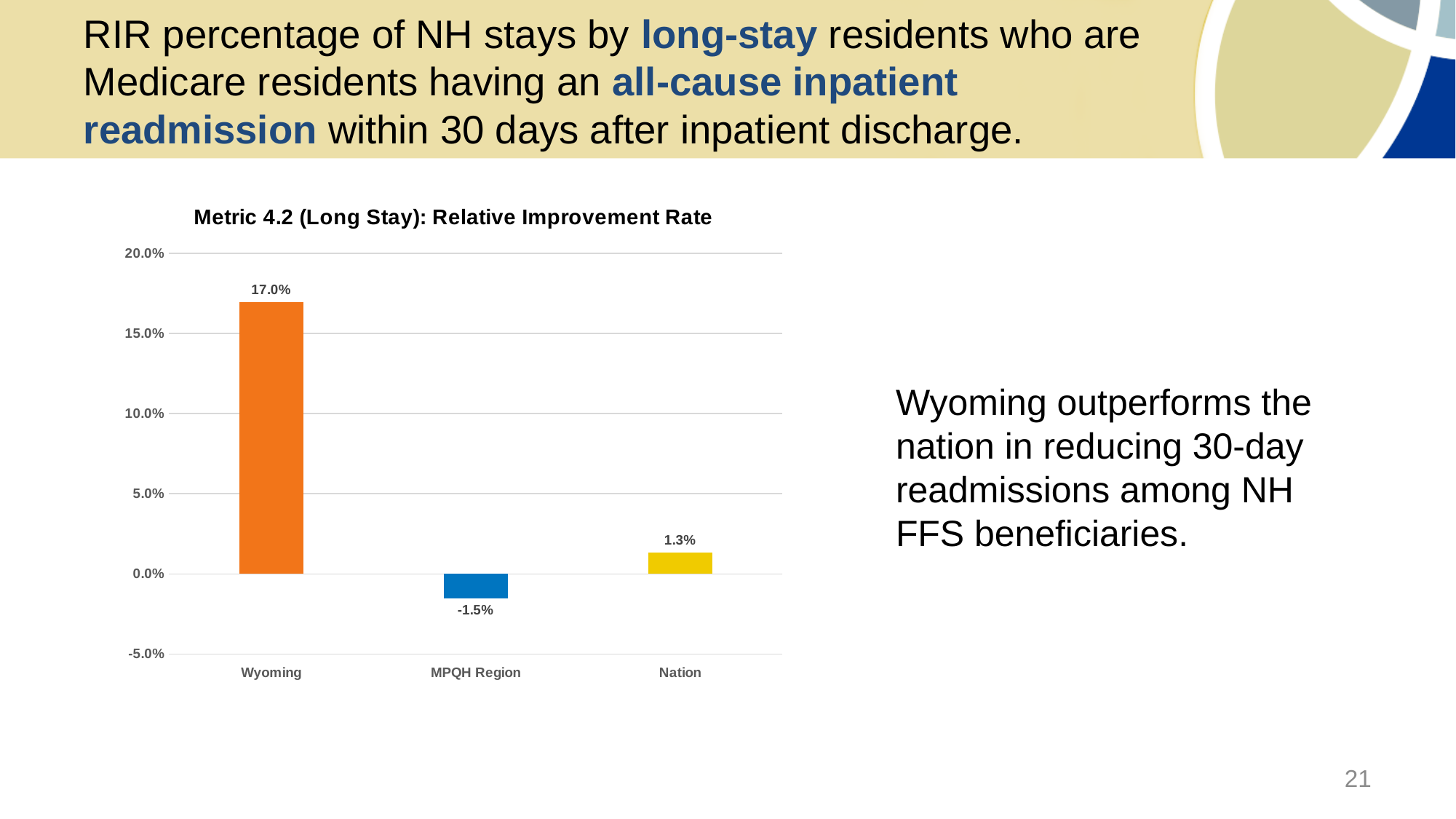
Which category has the lowest relative improvement rate? MPQH Region How many categories are shown on the x axis? 3 What is the relative improvement rate for the Nation? 1.3% What is the relative improvement rate for Wyoming? 17.0% Is the value for Wyoming greater or less than 15.0%? greater What is the difference between the Nation's and the MPQH Region's relative improvement rates? 2.8% What is the title of the chart? Metric 4.2 (Long Stay): Relative Improvement Rate What is the difference between Wyoming's and the Nation's relative improvement rates? 15.7% What kind of chart is shown on the slide? Bar chart What is the relative improvement rate for the MPQH Region? -1.5% Which has a larger relative improvement rate, the Nation or the MPQH Region? Nation Which category has the highest relative improvement rate? Wyoming